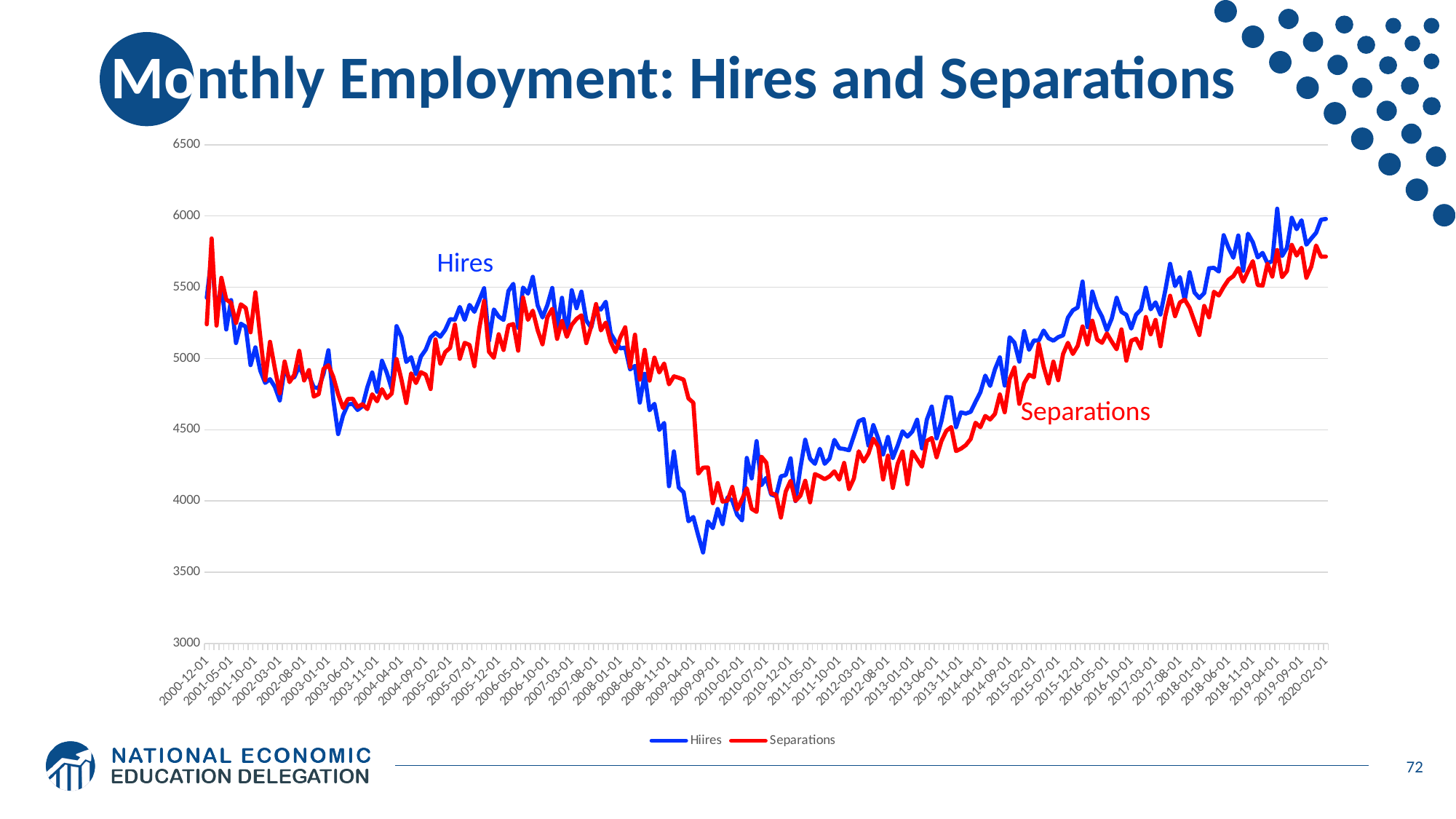
Which colour is used for the Separations series? red Is the value for Hires at 2020-02-01 greater or less than 5500? greater Is the value for Separations at 2011-05-01 greater or less than 4500? less What is the title of the chart on the slide? Monthly Employment: Hires and Separations At 2009-04-01, which series has the higher value, Hires or Separations? Separations Is the value for Hires at 2010-02-01 greater or less than 4500? less Do the Hires values rise or fall between 2009-09-01 and 2020-02-01? rise In which year does the Hires series reach its lowest point? 2009 How many series does the legend list? 2 What kind of chart is shown on the slide? line chart